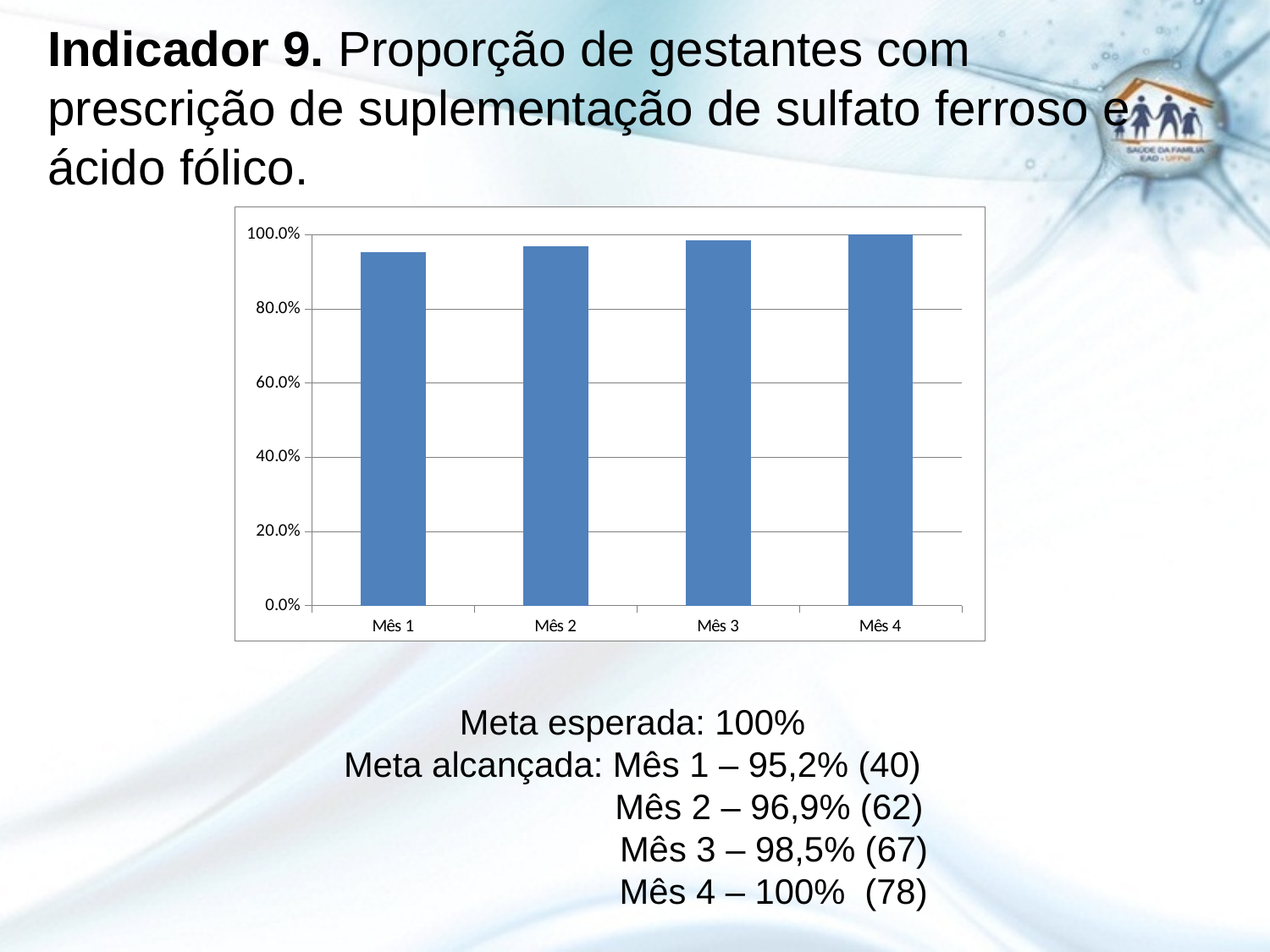
Do the bar values rise or fall from Mês 1 to Mês 4? Rise What kind of chart is shown on the slide? Bar chart Which month has the lowest bar in the chart? Mês 1 What value does the bar for Mês 4 reach? 100% What is the difference in percentage points between the value for Mês 4 and the value for Mês 1? 4,8 How many months (categories) are plotted on the x axis of the chart? 4 Is the value for Mês 1 greater or less than 80.0%? greater According to the slide, what proportion was achieved in Mês 3? 98,5% Which is larger, the value for Mês 2 or the value for Mês 3? Mês 3 Which month has the highest bar in the chart? Mês 4 What is the expected target (meta esperada) stated on the slide? 100% According to the slide, what proportion was achieved in Mês 1? 95,2%